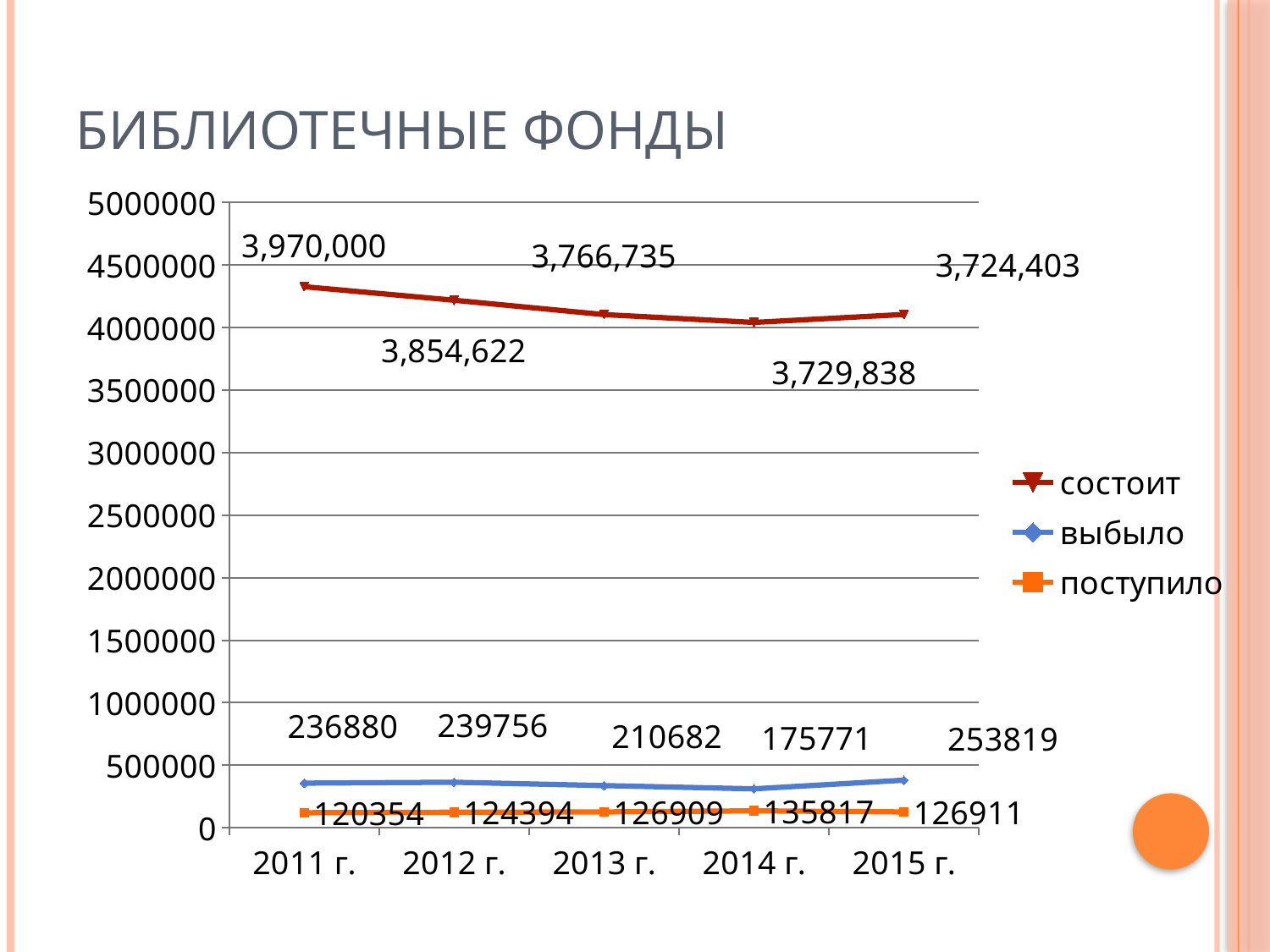
In which year is the выбыло series highest? 2015 г. How many series does the legend list? 3 What kind of chart is shown on the slide? line chart How many years are shown on the x axis? 5 What is the value of the поступило series in 2015 г.? 126911 What is the difference between the состоит values for 2011 г. and 2015 г.? 245,597 Does the состоит series rise or fall from 2011 г. to 2014 г.? fall What is the value of the состоит series in 2011 г.? 3,970,000 Which is larger in 2013 г.: the выбыло value or the поступило value? выбыло Is the состоит value for 2014 г. greater or less than 3000000? greater In which year is the поступило series lowest? 2011 г. What is the value of the выбыло series in 2014 г.? 175771